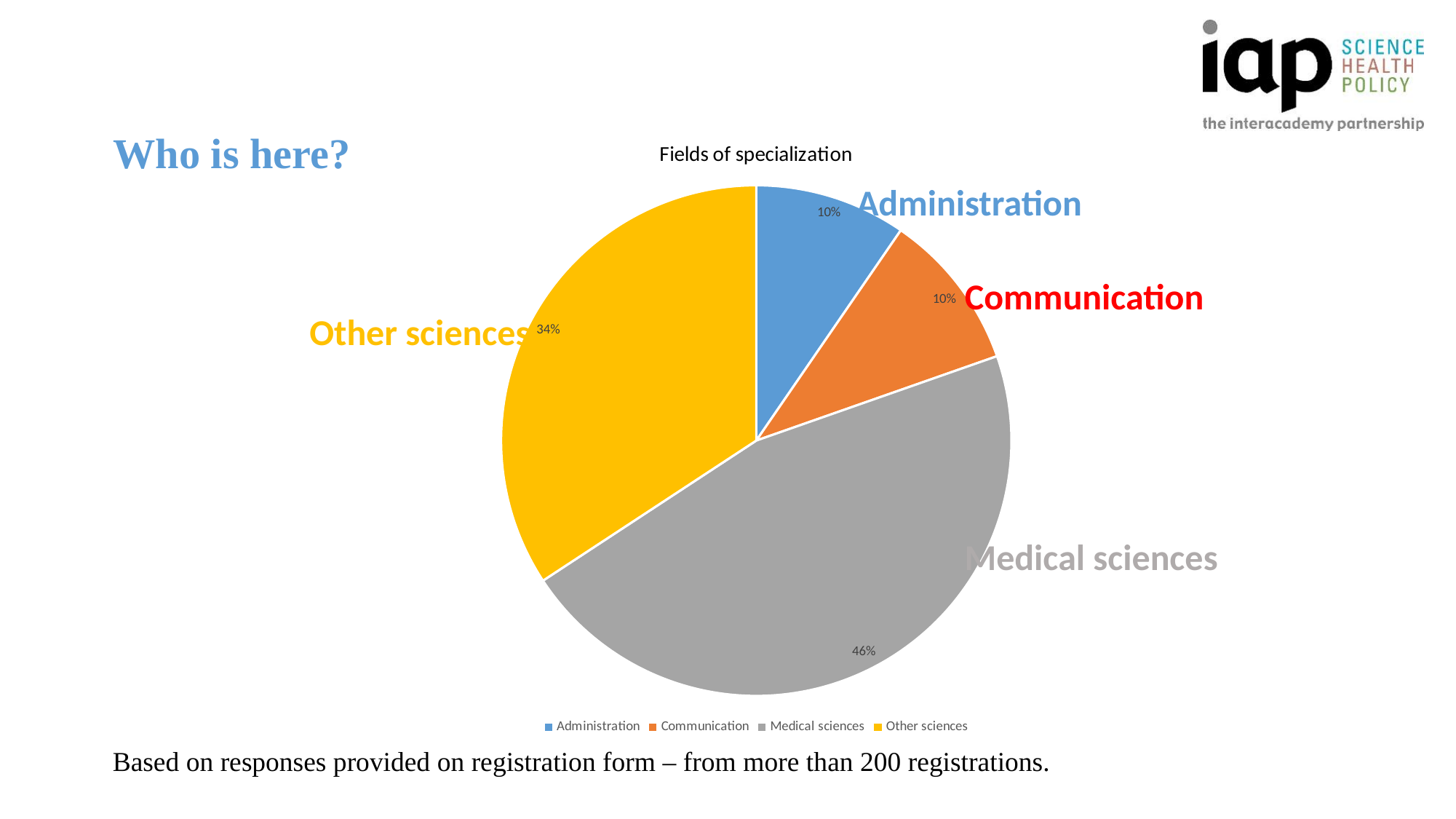
How many slices does the pie chart have? 4 Which is larger, the share for Other sciences or the share for Administration? Other sciences What colour is the Medical sciences slice? grey How many entries does the legend list? 4 What is the value shown for Administration? 10% What is the value shown for Communication? 10% What share of the pie does Medical sciences represent? 46% What is the title of the chart? Fields of specialization What share of the pie does Other sciences represent? 34% Which field of specialization has the largest share? Medical sciences What type of chart is shown on the slide? pie chart What is the difference between the shares of Medical sciences and Other sciences? 12%